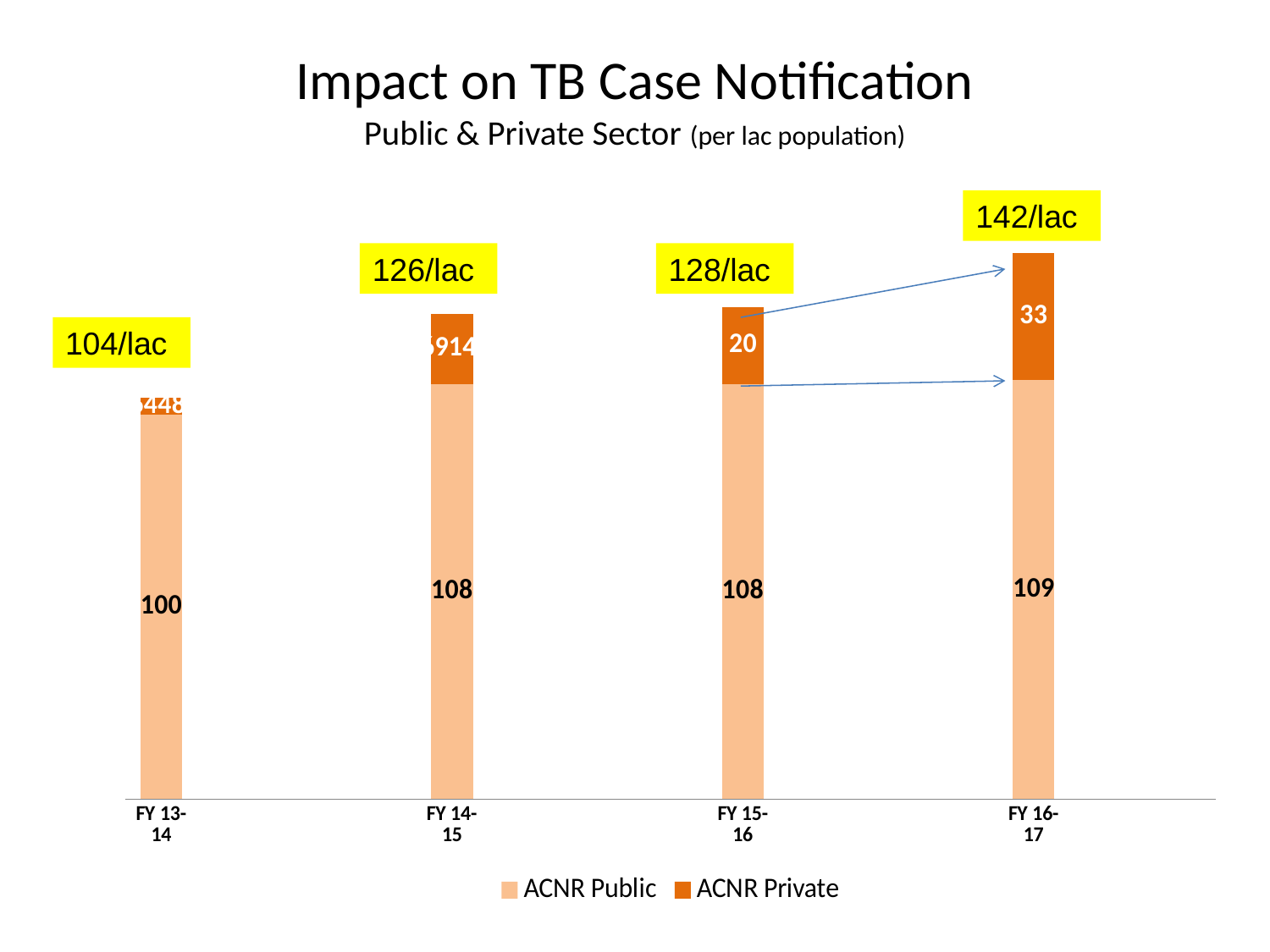
How many fiscal years are shown on the x axis? 4 What is the ACNR Public value for FY 13-14? 100 Which fiscal year has the highest ACNR Private value? FY 16-17 What total notification rate is shown in the callout for FY 13-14? 104/lac How many series does the legend list? 2 Is the ACNR Public value larger in FY 16-17 or FY 13-14? FY 16-17 What is the ACNR Private value for FY 16-17? 33 What is the ACNR Private value for FY 15-16? 20 Which fiscal year has the lowest ACNR Public value? FY 13-14 What is the difference between the ACNR Private values for FY 16-17 and FY 15-16? 13 What total notification rate is shown in the callout above the FY 16-17 bar? 142/lac What is the ACNR Public value for FY 16-17? 109